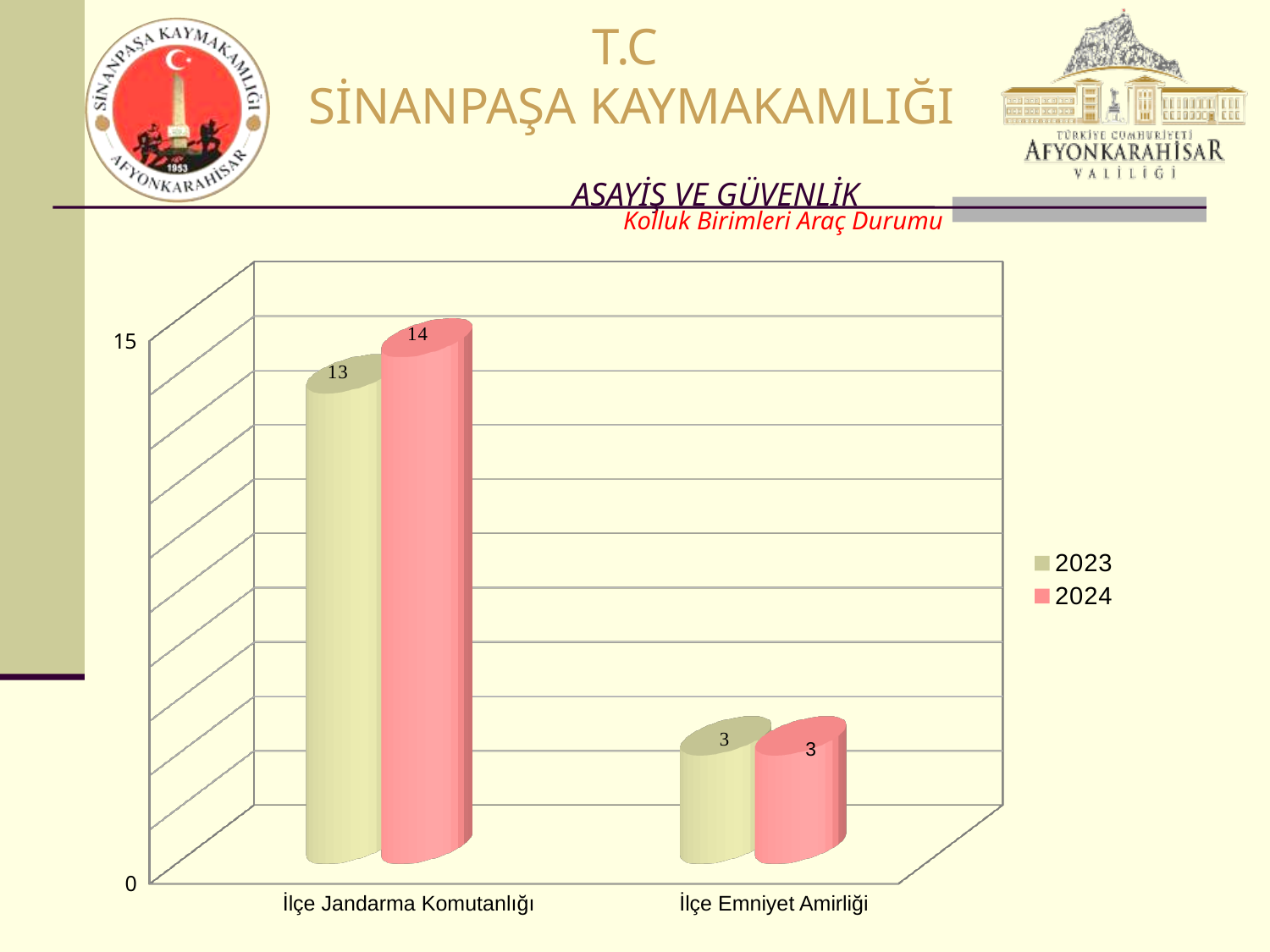
How many categories are shown on the x axis? 2 What is the 2023 value for İlçe Emniyet Amirliği? 3 What is the 2023 value for İlçe Jandarma Komutanlığı? 13 What is the difference between the 2023 values for İlçe Jandarma Komutanlığı and İlçe Emniyet Amirliği? 10 Which is larger for İlçe Jandarma Komutanlığı, the 2023 value or the 2024 value? 2024 What is the difference between the 2024 and 2023 values for İlçe Jandarma Komutanlığı? 1 What is the 2024 value for İlçe Jandarma Komutanlığı? 14 How many series does the legend list? 2 What kind of chart is shown on the slide? Bar chart What is the 2024 value for İlçe Emniyet Amirliği? 3 Which category has the highest 2024 value? İlçe Jandarma Komutanlığı Which category has the lowest 2023 value? İlçe Emniyet Amirliği